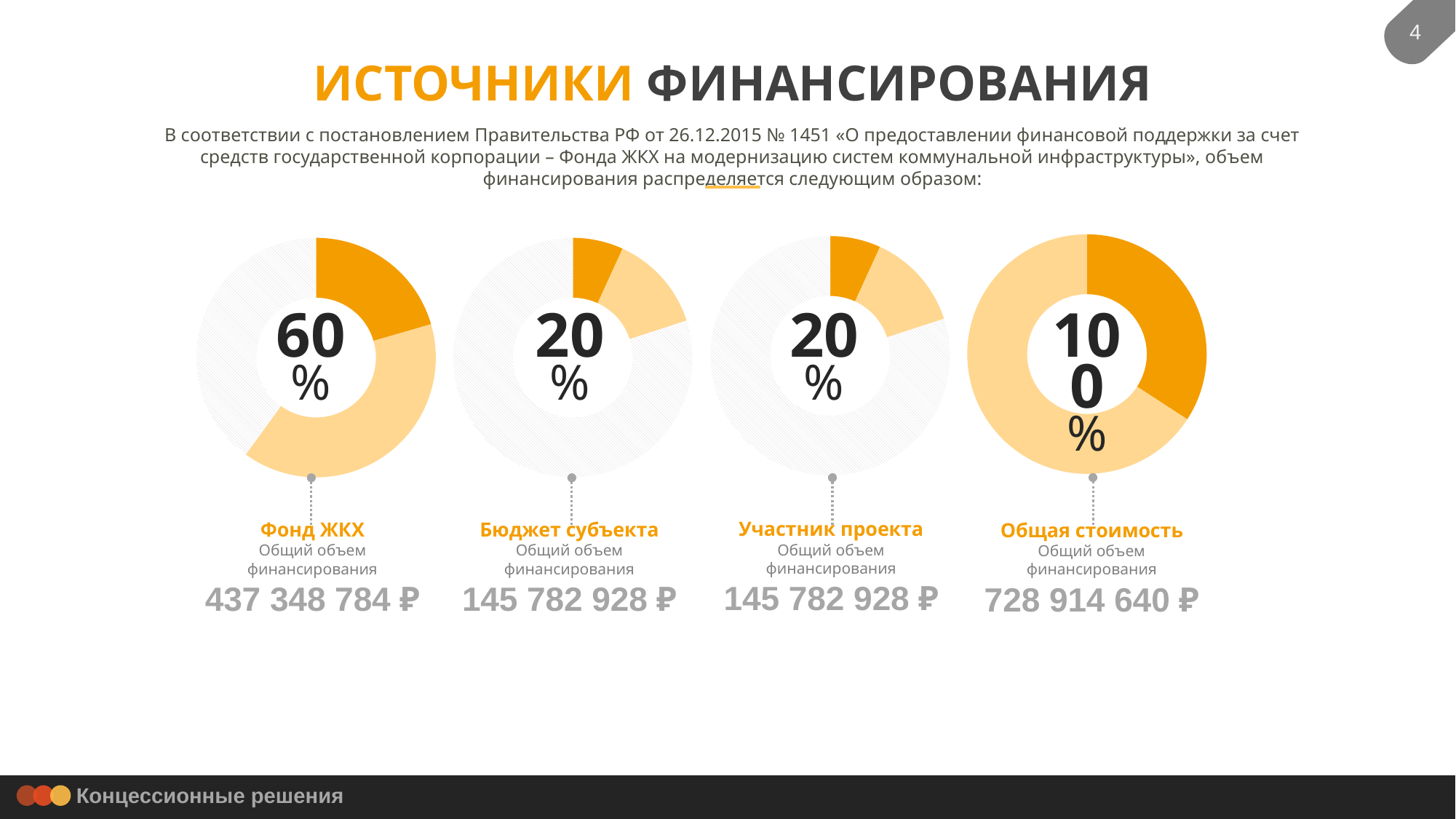
What is the sum of the funding amounts for Фонд ЖКХ, Бюджет субъекта and Участник проекта? 728 914 640 ₽ What is the amount shown under the Общая стоимость chart? 728 914 640 ₽ What is the difference between the funding amounts for Фонд ЖКХ and Бюджет субъекта? 291 565 856 ₽ By how many percentage points does the Фонд ЖКХ share exceed the Бюджет субъекта share? 40 percentage points What percentage is shown in the donut chart for Участник проекта? 20% What is the title of the slide containing the donut charts? ИСТОЧНИКИ ФИНАНСИРОВАНИЯ What percentage is shown in the donut chart for Фонд ЖКХ? 60% Which is larger: the share for Фонд ЖКХ or the share for Участник проекта? Фонд ЖКХ What is the total funding amount shown under the Бюджет субъекта chart? 145 782 928 ₽ What type of chart is used to show the funding shares on this slide? Donut chart How many donut charts are shown on the slide? 4 Among Фонд ЖКХ, Бюджет субъекта and Участник проекта, which source has the largest share of funding? Фонд ЖКХ